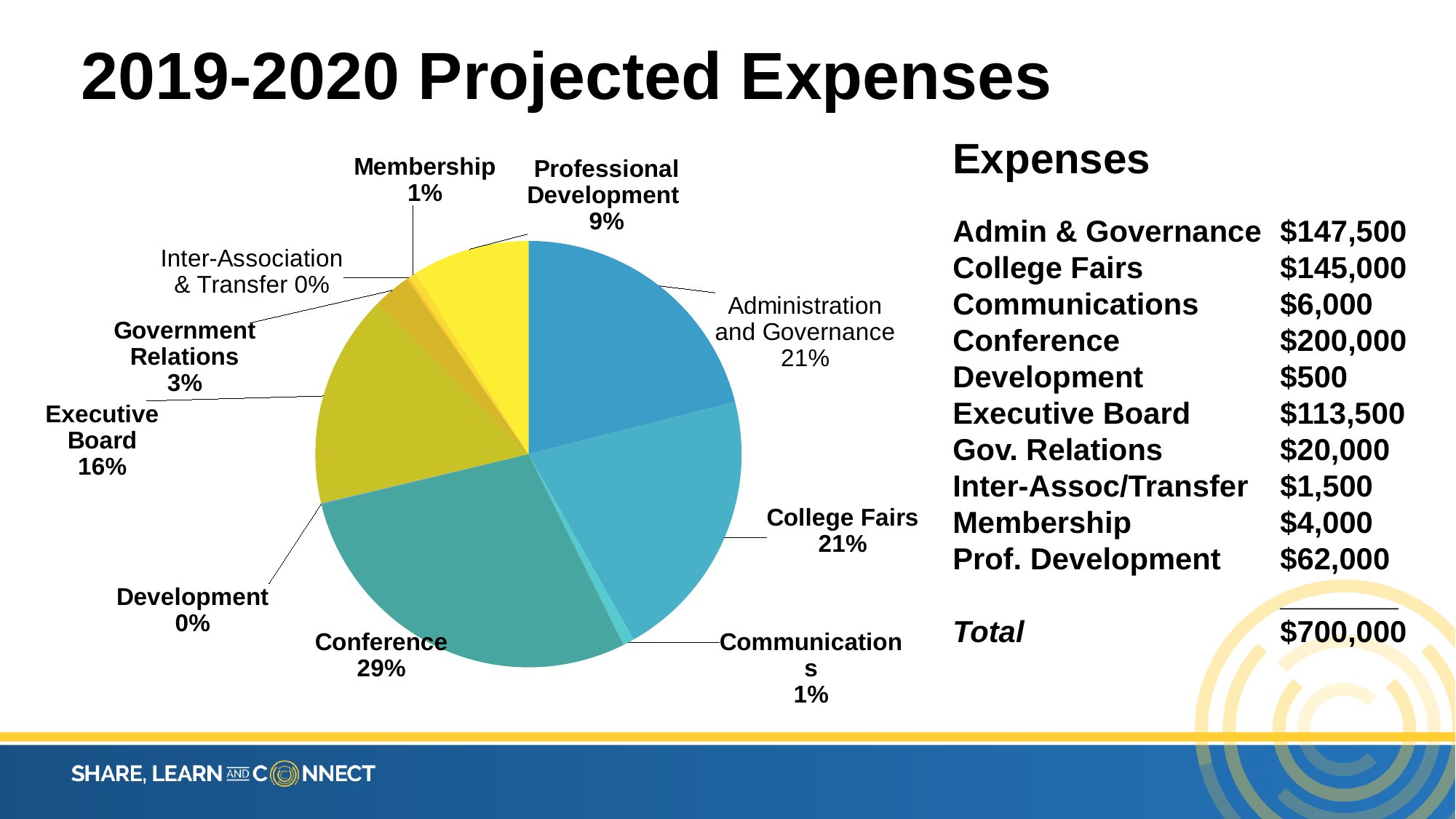
Which slice is larger, Professional Development or Government Relations? Professional Development Which slice is larger, Conference or Executive Board? Conference What kind of chart is shown on the slide? Pie chart What percentage is shown for Professional Development? 9% What share of the pie does Conference account for? 29% Which category has the largest slice of the pie? Conference What is the title of the slide containing the chart? 2019-2020 Projected Expenses What percentage is shown for College Fairs? 21% What percentage is shown for Government Relations? 3% What percentage is shown for Executive Board in the pie chart? 16% How many percentage points larger is the Conference slice than the Executive Board slice? 13 percentage points How many categories are shown in the pie chart? 10